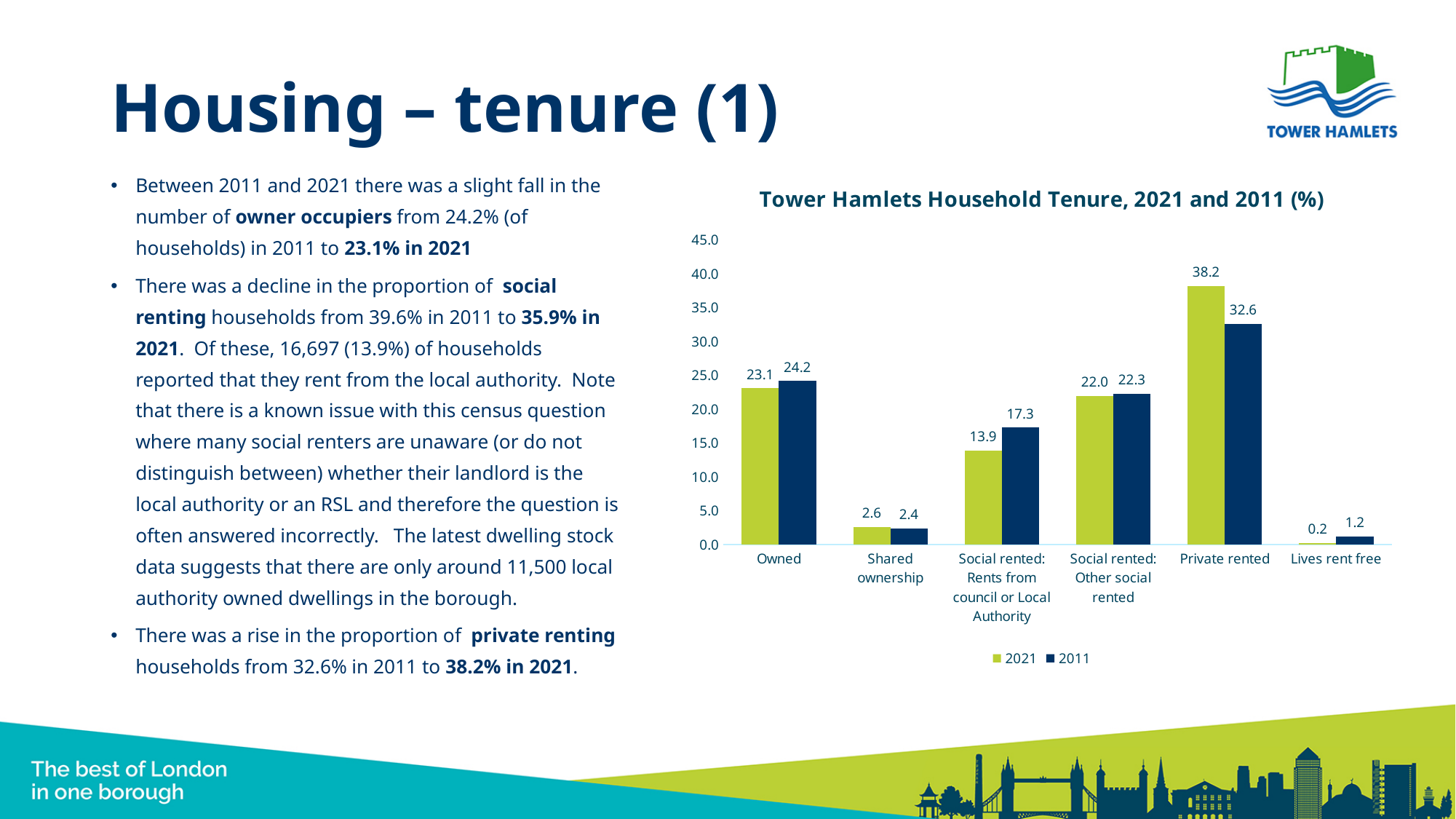
How many tenure categories are shown on the x axis? 6 Which is larger for Owned: the 2021 value or the 2011 value? 2011 What is the 2011 value for Social rented: Rents from council or Local Authority? 17.3 Which category has the lowest 2011 value? Lives rent free What is the 2021 value for Private rented? 38.2 What kind of chart is shown? bar chart Which category has the highest 2021 value? Private rented Is the 2011 value for Social rented: Other social rented greater or less than 20.0? greater How many series does the legend list? 2 What is the title of the chart? Tower Hamlets Household Tenure, 2021 and 2011 (%) What is the difference between the 2021 and 2011 values for Private rented? 5.6 What is the 2021 value for Lives rent free? 0.2